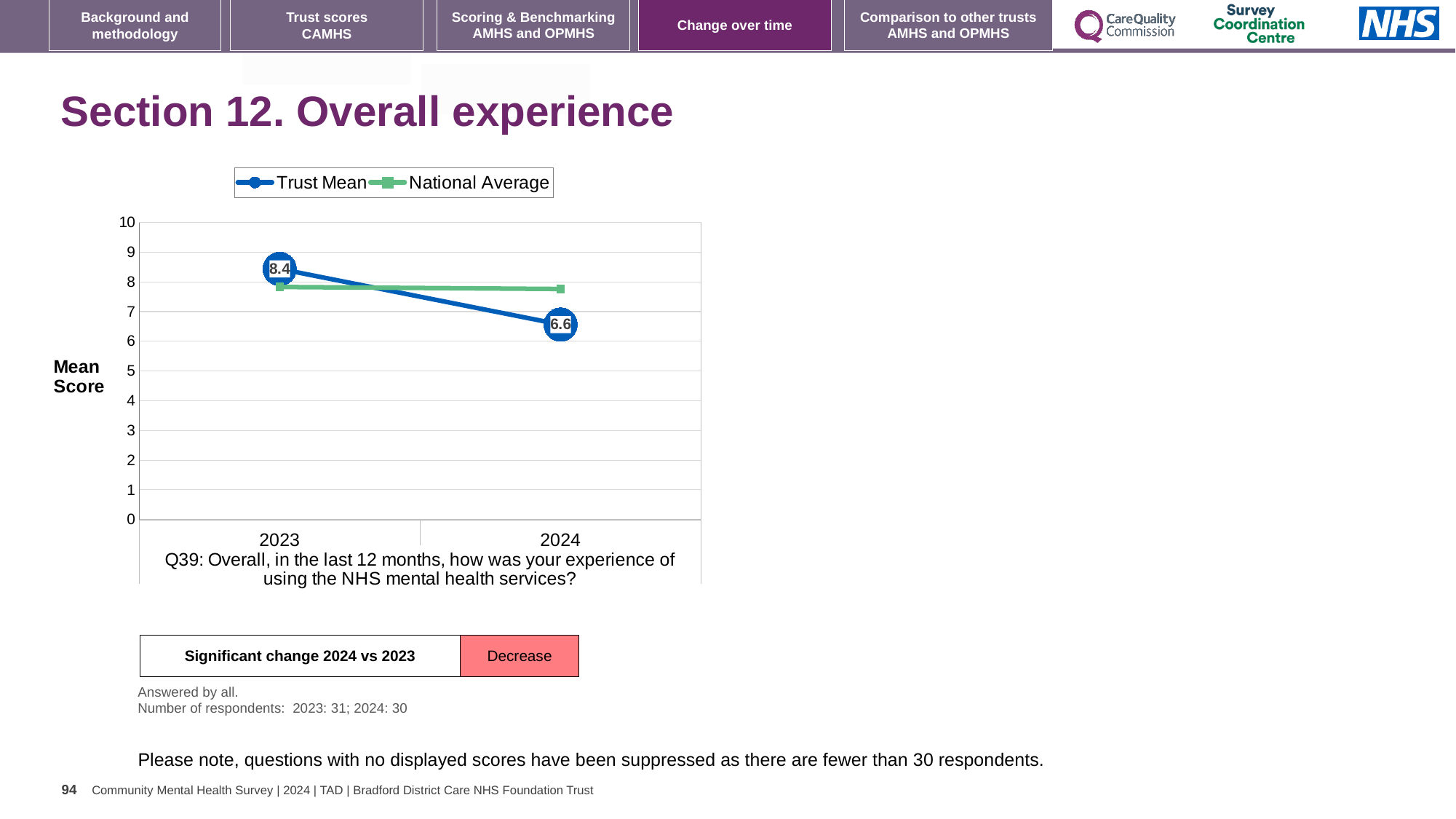
What is the Trust Mean score for 2024? 6.6 In 2024, which is higher: the Trust Mean or the National Average? National Average What is the Trust Mean score for 2023? 8.4 Does the Trust Mean rise or fall from 2023 to 2024? fall What is the label on the vertical axis of the chart? Mean Score In which year is the Trust Mean score higher? 2023 How many series does the legend list? 2 Is the National Average value for 2024 greater or less than 7? greater In which year is the Trust Mean score lowest? 2024 What kind of chart is shown on the slide? line chart By how much did the Trust Mean score change from 2023 to 2024? 1.8 In 2023, which is higher: the Trust Mean or the National Average? Trust Mean